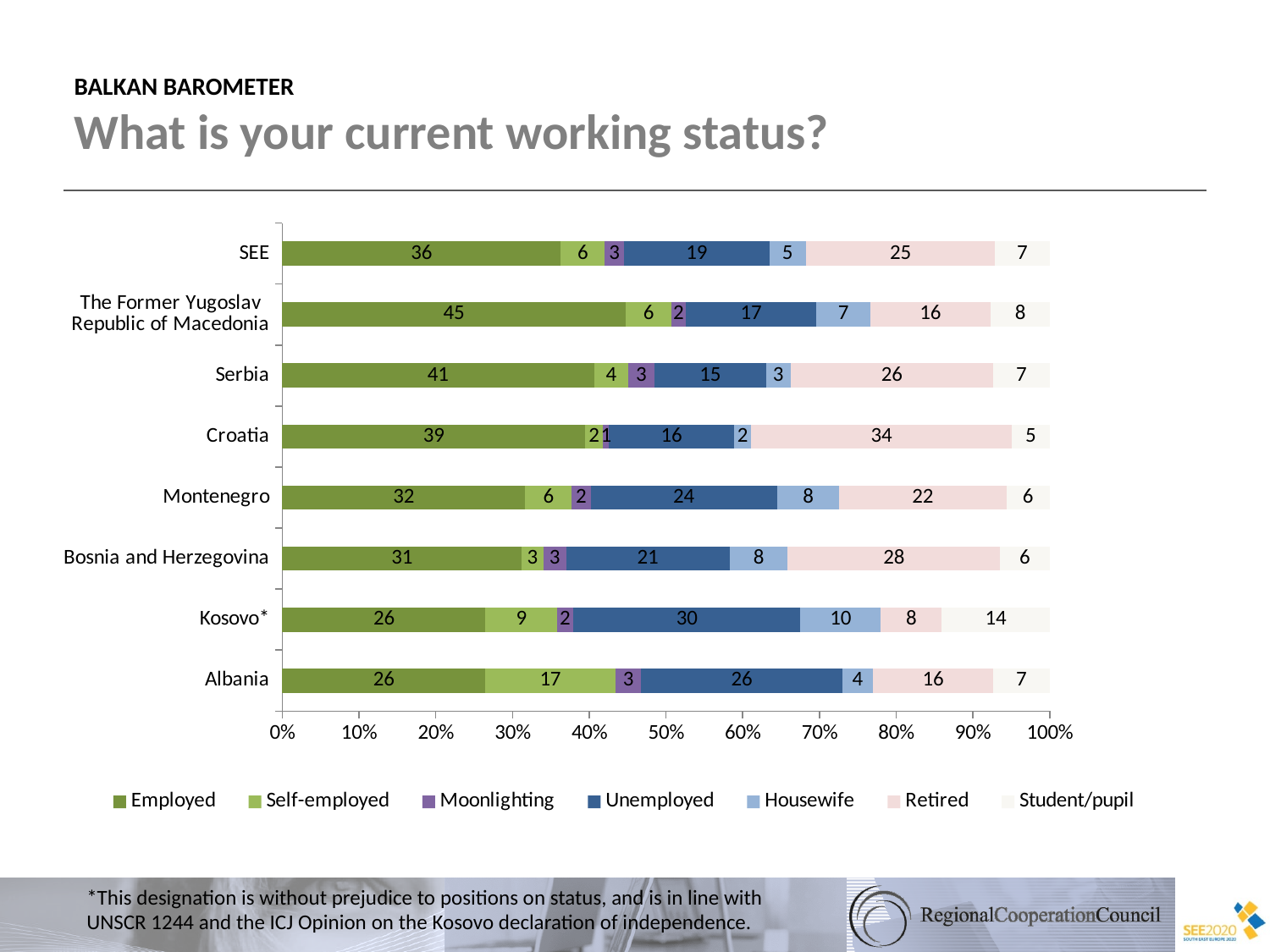
Which category has the highest Employed value? The Former Yugoslav Republic of Macedonia What is the Unemployed value for Kosovo*? 30 How many categories (economies/regions) are shown on the y axis? 8 What is the Retired value for Croatia? 34 How many series does the legend list? 7 Which is larger, the Housewife value for Montenegro or for Albania? Montenegro Which series is shown in the darkest green colour in the legend? Employed What kind of chart is shown on the slide? Stacked bar chart What is the difference between the Unemployed values for Kosovo* and Serbia? 15 What is the Employed value for Serbia? 41 Which category has the lowest Retired value? Kosovo* What is the Self-employed value for Albania? 17